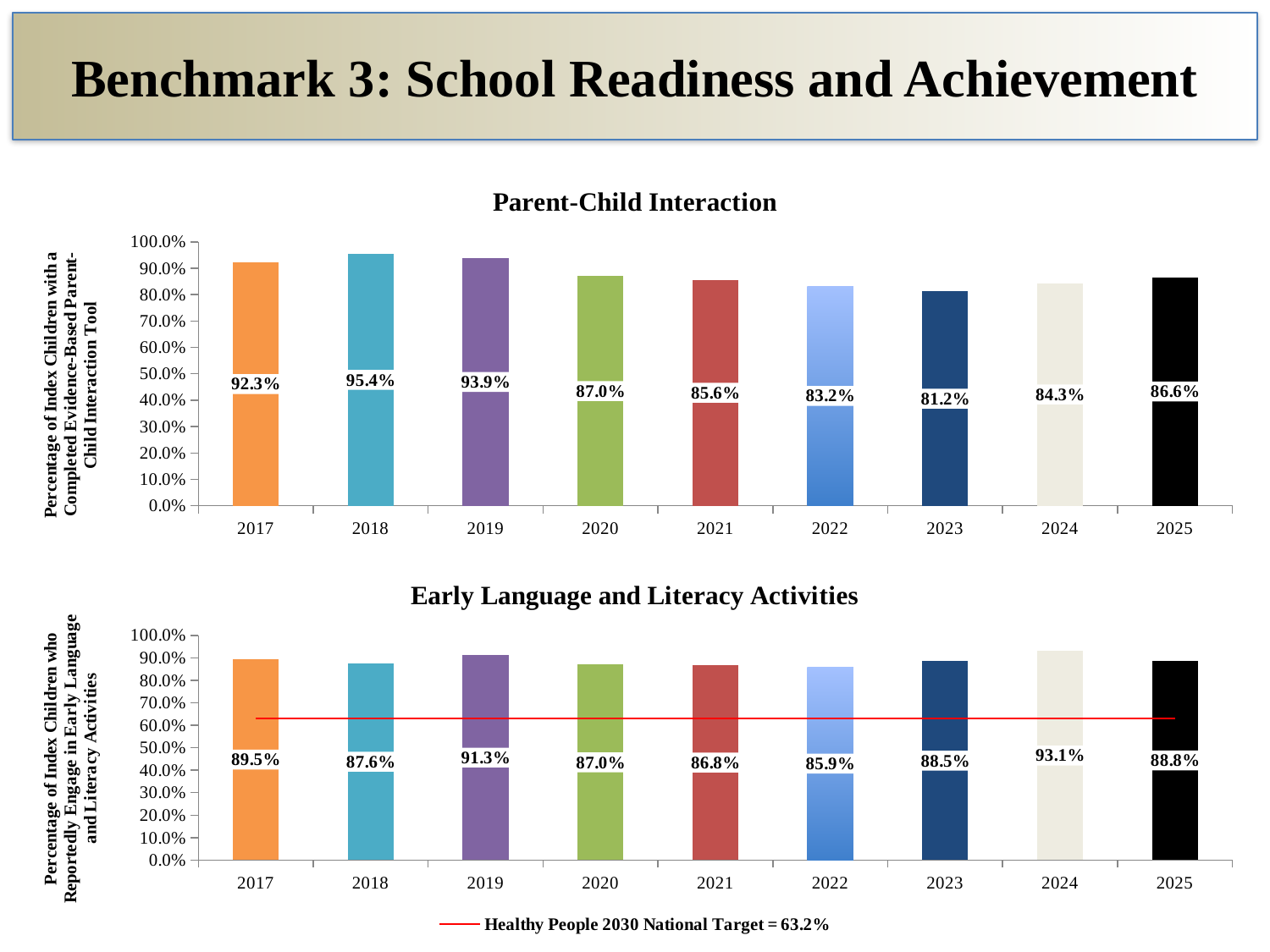
In the Parent-Child Interaction chart, what is the value for 2018? 95.4% In the Parent-Child Interaction chart, what is the difference between the 2017 and 2025 values? 5.7% In the Parent-Child Interaction chart, which year has the lowest value? 2023 In the Early Language and Literacy Activities chart, what value does the Healthy People 2030 National Target line represent? 63.2% How many years are shown on the x axis of the Parent-Child Interaction chart? 9 In the Early Language and Literacy Activities chart, is the value for 2019 or 2020 larger? 2019 In the Early Language and Literacy Activities chart, which year has the lowest value? 2022 What kind of chart is the Early Language and Literacy Activities chart? Bar chart In the Parent-Child Interaction chart, is the value for 2022 greater or less than 90.0%? less In the Parent-Child Interaction chart, which year has the highest value? 2018 In the Early Language and Literacy Activities chart, what is the value for 2024? 93.1% In the Early Language and Literacy Activities chart, which year has the highest value? 2024